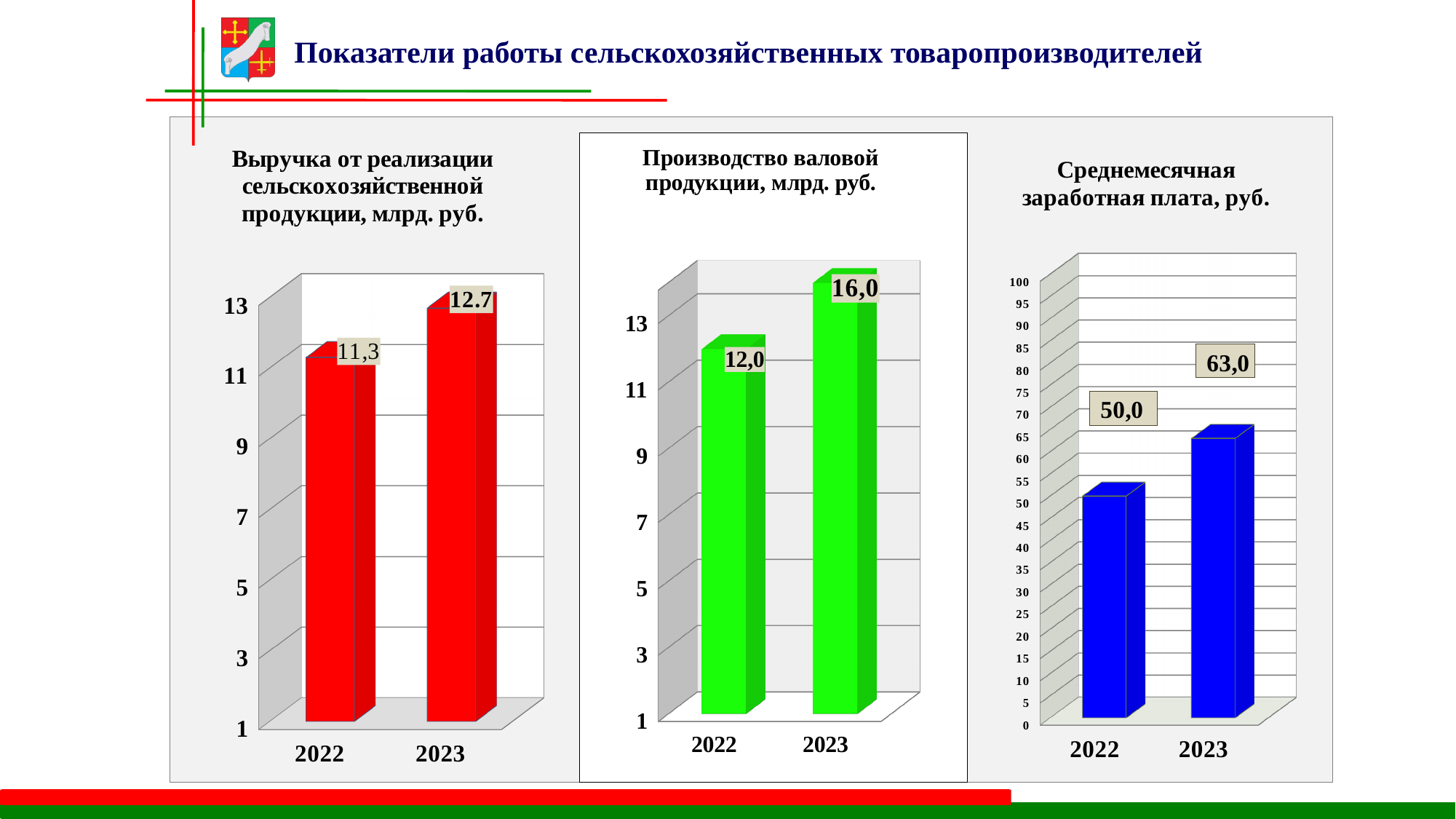
In the chart titled "Производство валовой продукции, млрд. руб.", what is the difference between the 2023 and 2022 values? 4,0 In the chart titled "Выручка от реализации сельскохозяйственной продукции, млрд. руб.", do the values rise or fall from 2022 to 2023? rise In the chart titled "Производство валовой продукции, млрд. руб.", what is the value for 2023? 16,0 In the chart titled "Выручка от реализации сельскохозяйственной продукции, млрд. руб.", what is the value for 2023? 12.7 In the chart titled "Среднемесячная заработная плата, руб.", which year has the higher value? 2023 In the chart titled "Производство валовой продукции, млрд. руб.", what is the value for 2022? 12,0 How many categories are shown on the x axis of the chart titled "Производство валовой продукции, млрд. руб."? 2 In the chart titled "Выручка от реализации сельскохозяйственной продукции, млрд. руб.", what is the value for 2022? 11,3 In the chart titled "Среднемесячная заработная плата, руб.", what is the value for 2022? 50,0 In the chart titled "Среднемесячная заработная плата, руб.", what is the value for 2023? 63,0 What kind of chart is the chart titled "Среднемесячная заработная плата, руб."? bar chart In the chart titled "Среднемесячная заработная плата, руб.", what is the difference between the 2023 and 2022 values? 13,0